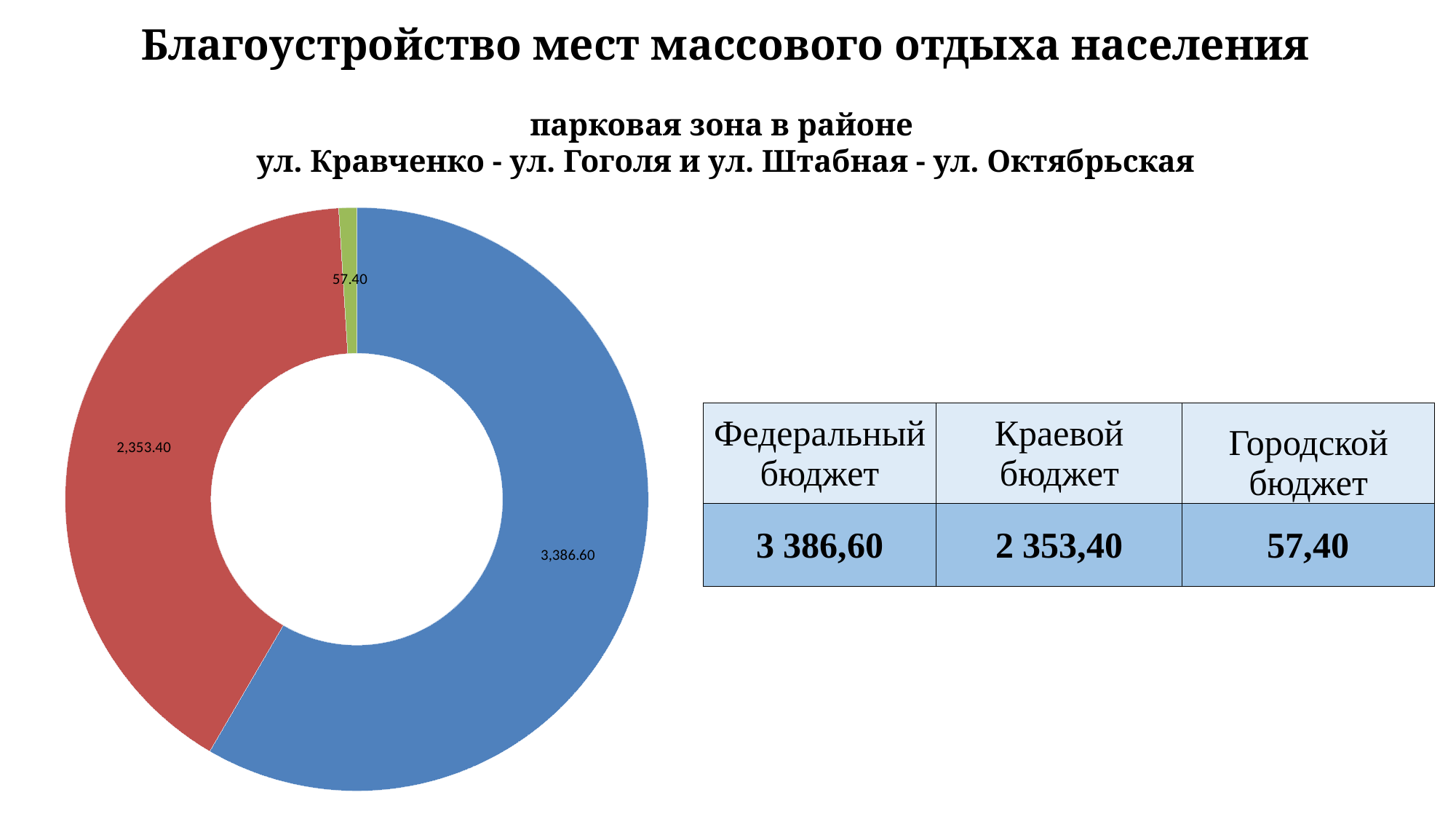
What value is labelled on the smallest (green) slice of the doughnut chart? 57.40 What is the difference between the Федеральный бюджет and Краевой бюджет amounts? 1 033,20 Which budget source has the smallest value? Городской бюджет What is the total of the three budget amounts shown? 5 797,40 How many slices does the doughnut chart have? 3 According to the table, what is the amount from the Городской бюджет? 57,40 What value is labelled on the largest (blue) slice of the doughnut chart? 3,386.60 Which budget source has the largest value? Федеральный бюджет According to the table, what is the amount from the Федеральный бюджет? 3 386,60 What value is labelled on the red slice of the doughnut chart? 2,353.40 Which is larger, the Краевой бюджет or the Городской бюджет amount? Краевой бюджет What type of chart is shown on the slide? Doughnut (pie) chart